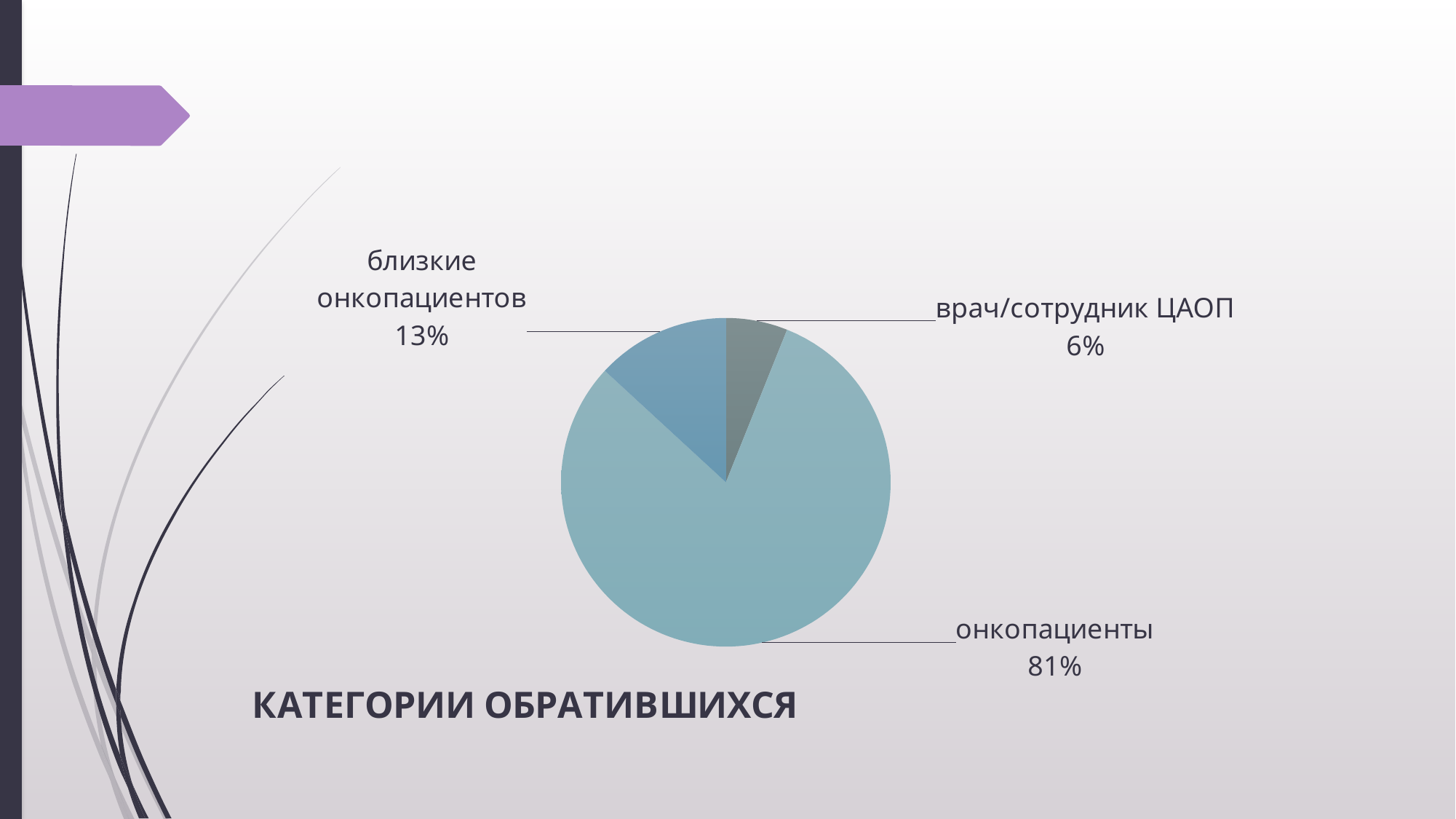
What is the difference in percentage points between the близкие онкопациентов slice and the врач/сотрудник ЦАОП slice? 7 How many categories are shown in the pie chart? 3 What is the difference in percentage points between the онкопациенты slice and the близкие онкопациентов slice? 68 What is the combined share of the близкие онкопациентов and врач/сотрудник ЦАОП slices? 19% What share of the pie does the slice for близкие онкопациентов represent? 13% Which is larger: the slice for близкие онкопациентов or the slice for врач/сотрудник ЦАОП? близкие онкопациентов Which category has the smallest slice of the pie? врач/сотрудник ЦАОП What share of the pie does the slice for онкопациенты represent? 81% What share of the pie does the slice for врач/сотрудник ЦАОП represent? 6% What kind of chart is shown on the slide? pie chart What is the title of the chart on the slide? КАТЕГОРИИ ОБРАТИВШИХСЯ Which category has the largest slice of the pie? онкопациенты